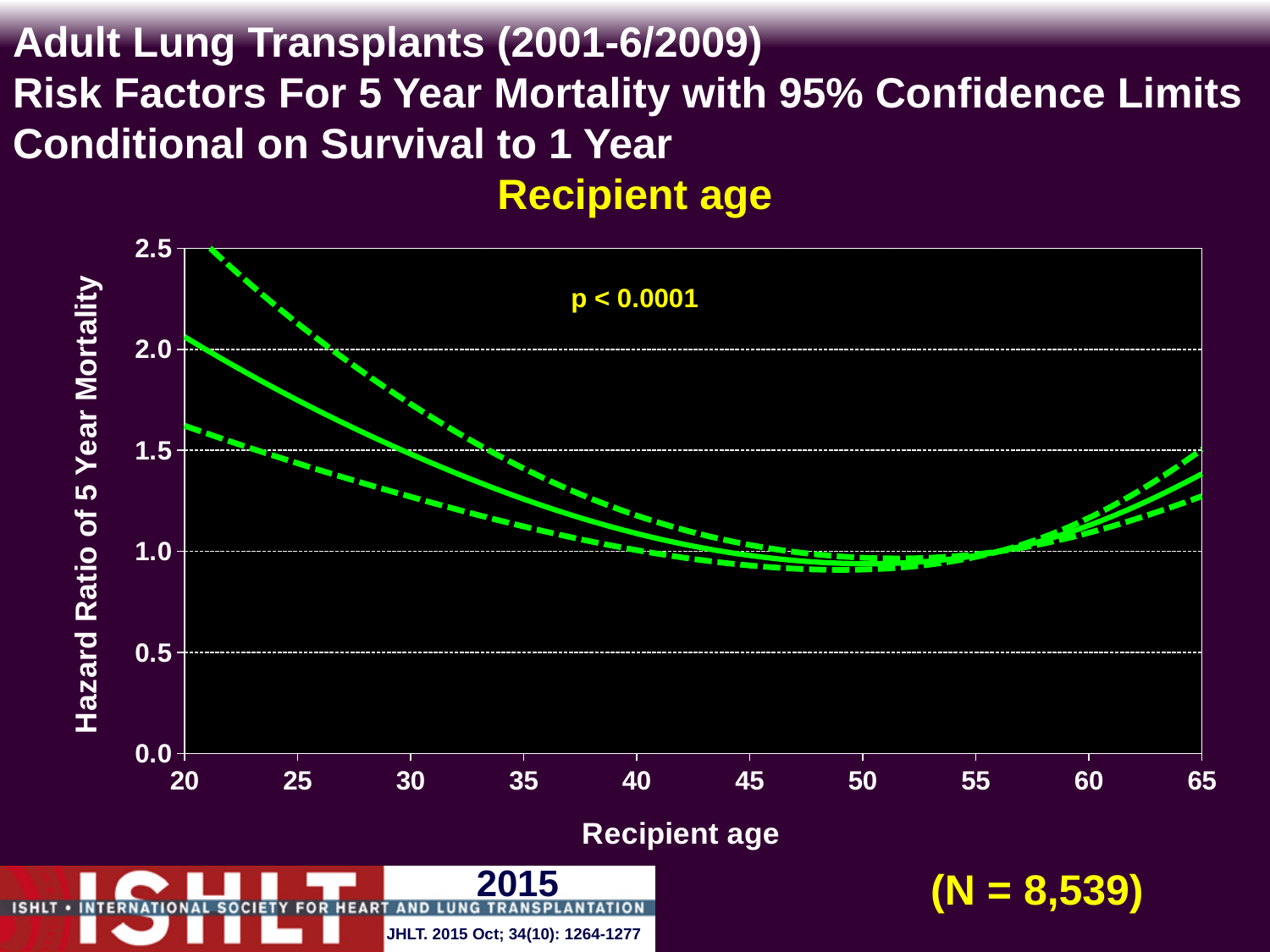
How many lines are plotted on the chart? 3 What p-value is printed on the chart? p < 0.0001 What is the title of the chart? Recipient age Is the hazard ratio (solid line) at recipient age 25 greater or less than 2.0? less Is the hazard ratio (solid line) at recipient age 40 greater or less than 1.5? less Is the hazard ratio (solid line) at recipient age 65 greater or less than 1.5? less What is the label of the y axis? Hazard Ratio of 5 Year Mortality What kind of chart is shown on the slide? line chart Does the hazard ratio (solid line) rise or fall as recipient age increases from 55 to 65? rise Does the hazard ratio (solid line) rise or fall as recipient age increases from 20 to 45? fall Is the hazard ratio (solid line) higher at recipient age 25 or at recipient age 50? age 25